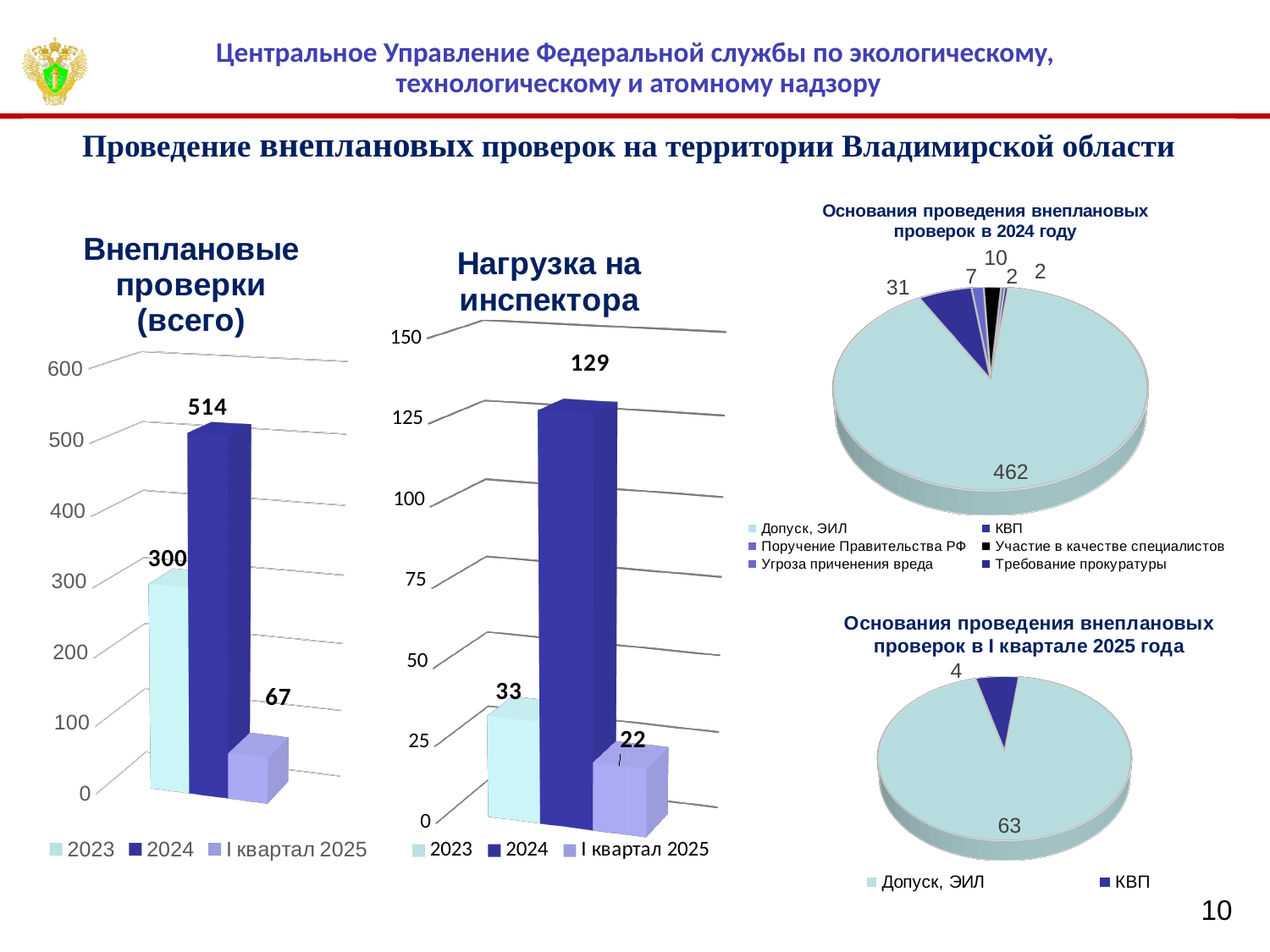
In the 'Нагрузка на инспектора' chart, what is the value for 2023? 33 In the 'Нагрузка на инспектора' chart, which series has the lowest value? I квартал 2025 In the 'Нагрузка на инспектора' chart, which series has the highest value? 2024 How many series does the legend of the 'Внеплановые проверки (всего)' chart list? 3 In the 'Основания проведения внеплановых проверок в I квартале 2025 года' pie chart, what is the value for КВП? 4 In the 'Нагрузка на инспектора' chart, what is the difference between the 2024 and I квартал 2025 values? 107 In the 'Основания проведения внеплановых проверок в I квартале 2025 года' pie chart, which slice is larger: Допуск, ЭИЛ or КВП? Допуск, ЭИЛ In the 'Внеплановые проверки (всего)' chart, what is the value for I квартал 2025? 67 In the 'Внеплановые проверки (всего)' chart, what is the value for 2024? 514 In the 'Основания проведения внеплановых проверок в 2024 году' pie chart, what is the value of the largest slice (Допуск, ЭИЛ)? 462 What type of chart is 'Основания проведения внеплановых проверок в 2024 году'? Pie chart In the 'Внеплановые проверки (всего)' chart, what is the difference between the 2024 and 2023 values? 214